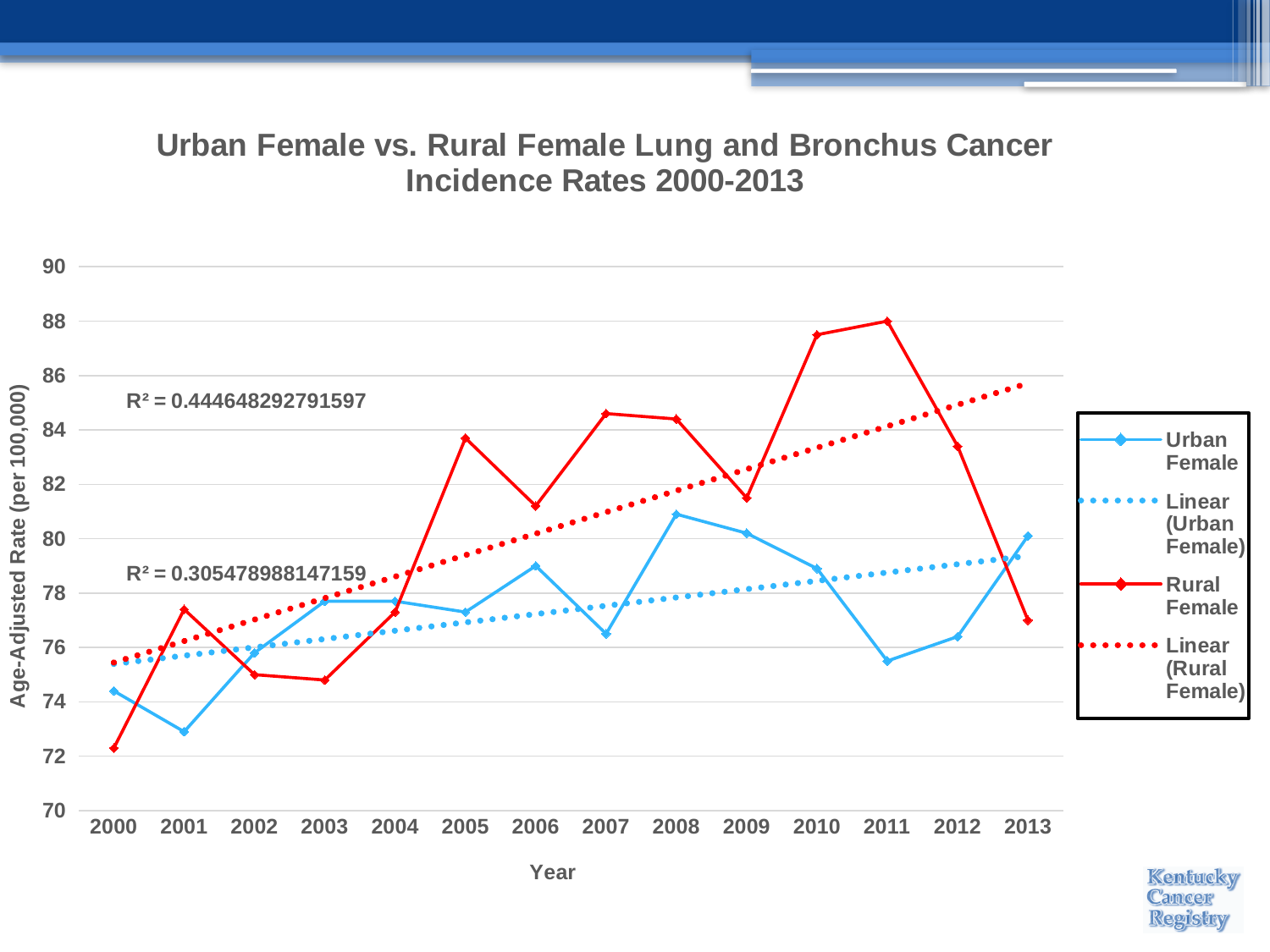
Is the Rural Female value for 2000 greater or less than 74? less Is the Urban Female value for 2011 greater or less than 76? less What R² value is shown for the upper (Rural Female) trendline? R² = 0.444648292791597 How many entries does the legend list? 4 In 2010, which series has the higher value, Urban Female or Rural Female? Rural Female Do the dotted linear trendlines rise or fall from 2000 to 2013? Rise What kind of chart is shown on the slide? Line chart In which year is the Rural Female incidence rate lowest? 2000 How many years are plotted along the x axis? 14 In 2000, which series has the higher value, Urban Female or Rural Female? Urban Female Is the Rural Female value for 2010 greater or less than 86? greater